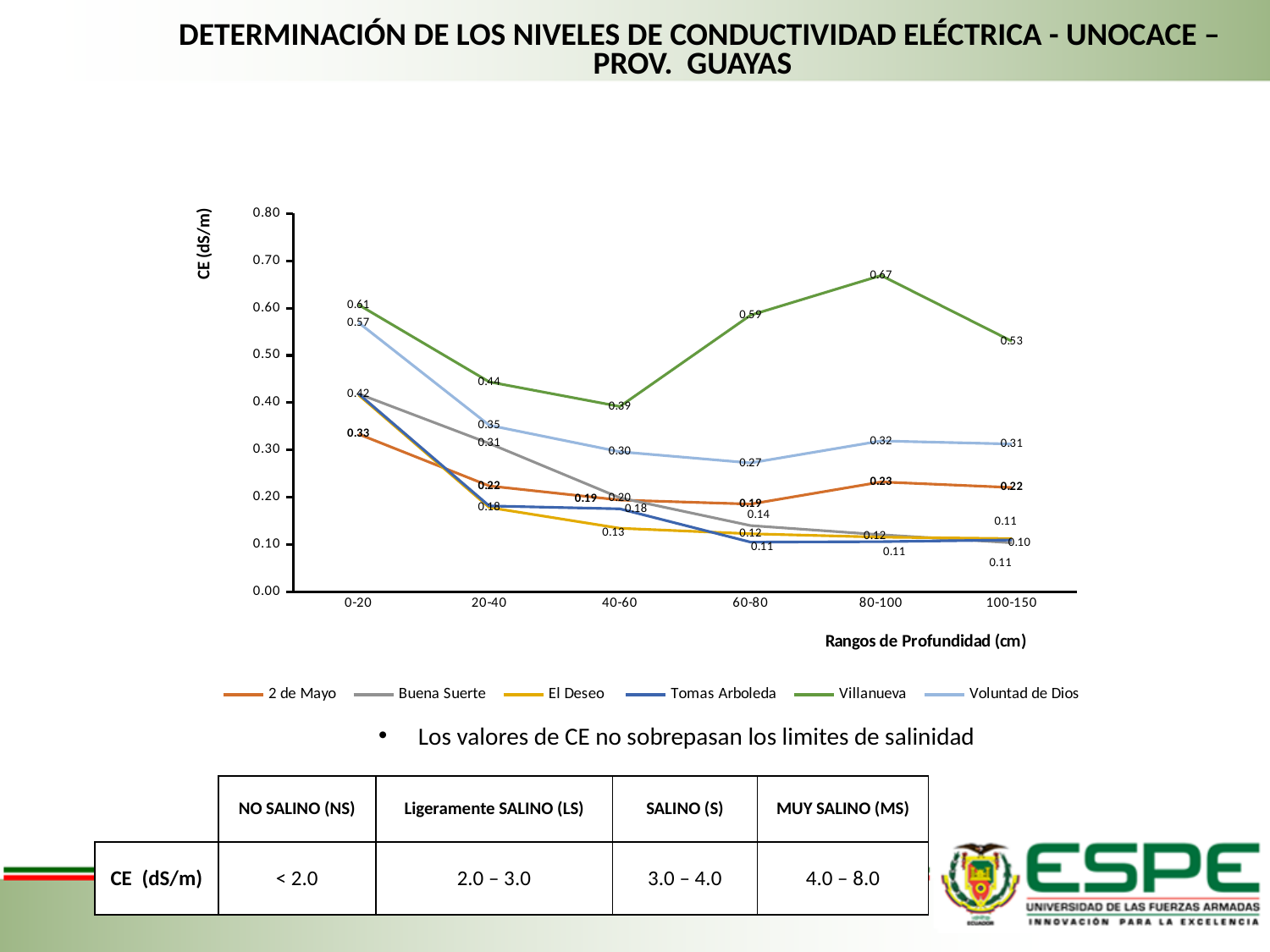
What is the CE value for Villanueva at the 80-100 depth range? 0.67 Which series has the highest CE value at the 80-100 depth range? Villanueva What is the difference between the Villanueva values at 80-100 and 100-150? 0.14 What is the CE value for Voluntad de Dios at the 0-20 depth range? 0.57 How many series does the legend list? 6 What is the CE value for 2 de Mayo at the 80-100 depth range? 0.23 Is the value for Villanueva at 60-80 greater or less than 0.50? greater At which depth range does Villanueva have its lowest CE value? 40-60 What is the CE value for Villanueva at the 0-20 depth range? 0.61 What kind of chart is shown on the slide? line chart At which depth range does Villanueva reach its highest CE value? 80-100 How many depth ranges are shown on the x axis? 6